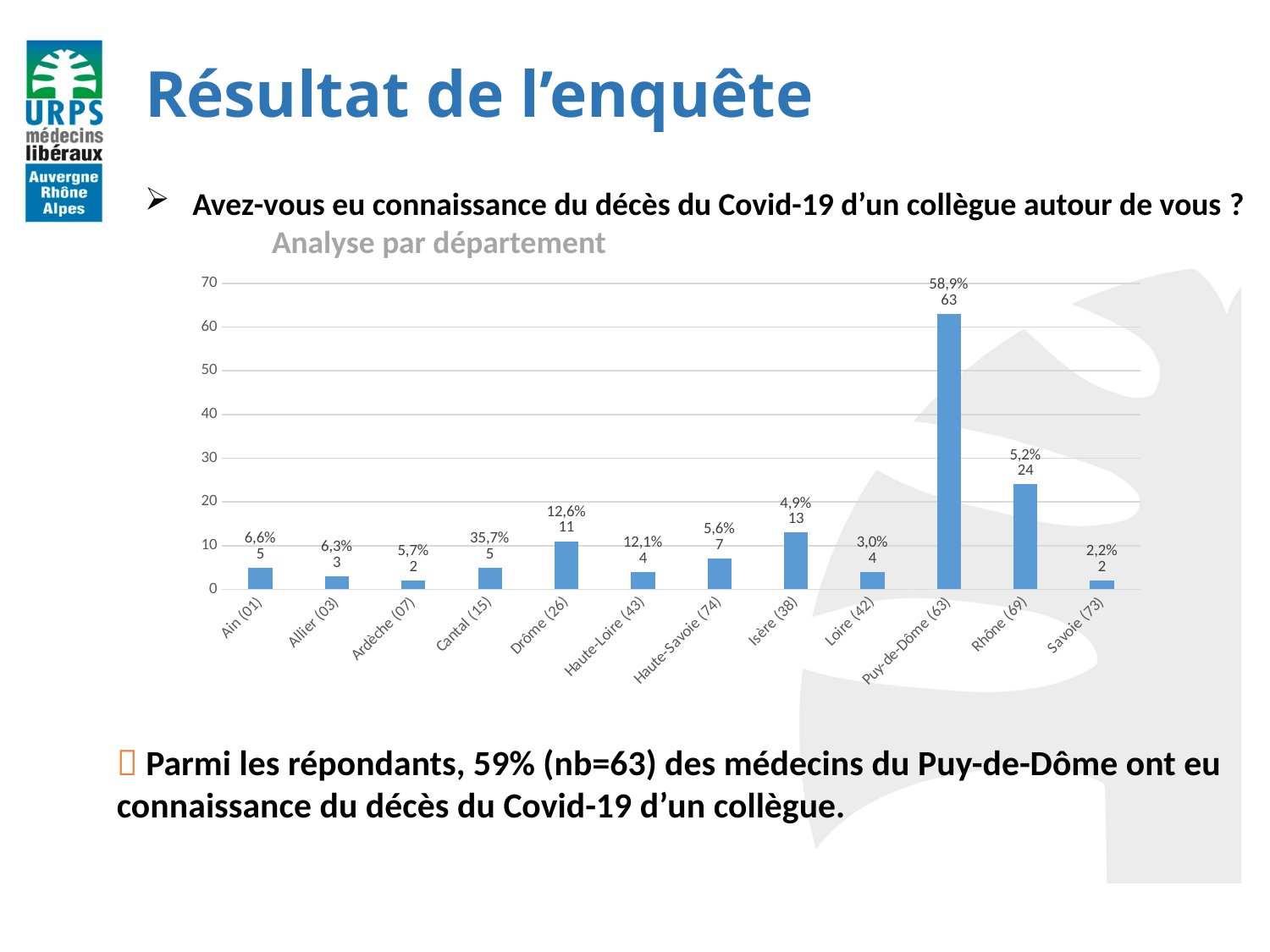
How many departments are shown on the x axis of the chart? 12 What kind of chart is used for the 'Analyse par département'? Bar chart What is the title of the chart on the slide? Analyse par département What is the difference between the values for Haute-Savoie (74) and Loire (42)? 3 Which is larger, the value for Drôme (26) or the value for Isère (38)? Isère (38) What is the value for Rhône (69)? 24 What is the difference between the values for Puy-de-Dôme (63) and Rhône (69)? 39 What percentage is shown for Isère (38)? 4,9% What is the value for Puy-de-Dôme (63) in the 'Analyse par département' chart? 63 Is the value for Puy-de-Dôme (63) greater or less than 60? greater What percentage is shown above the bar for Cantal (15)? 35,7% Which department has the highest bar in the chart? Puy-de-Dôme (63)